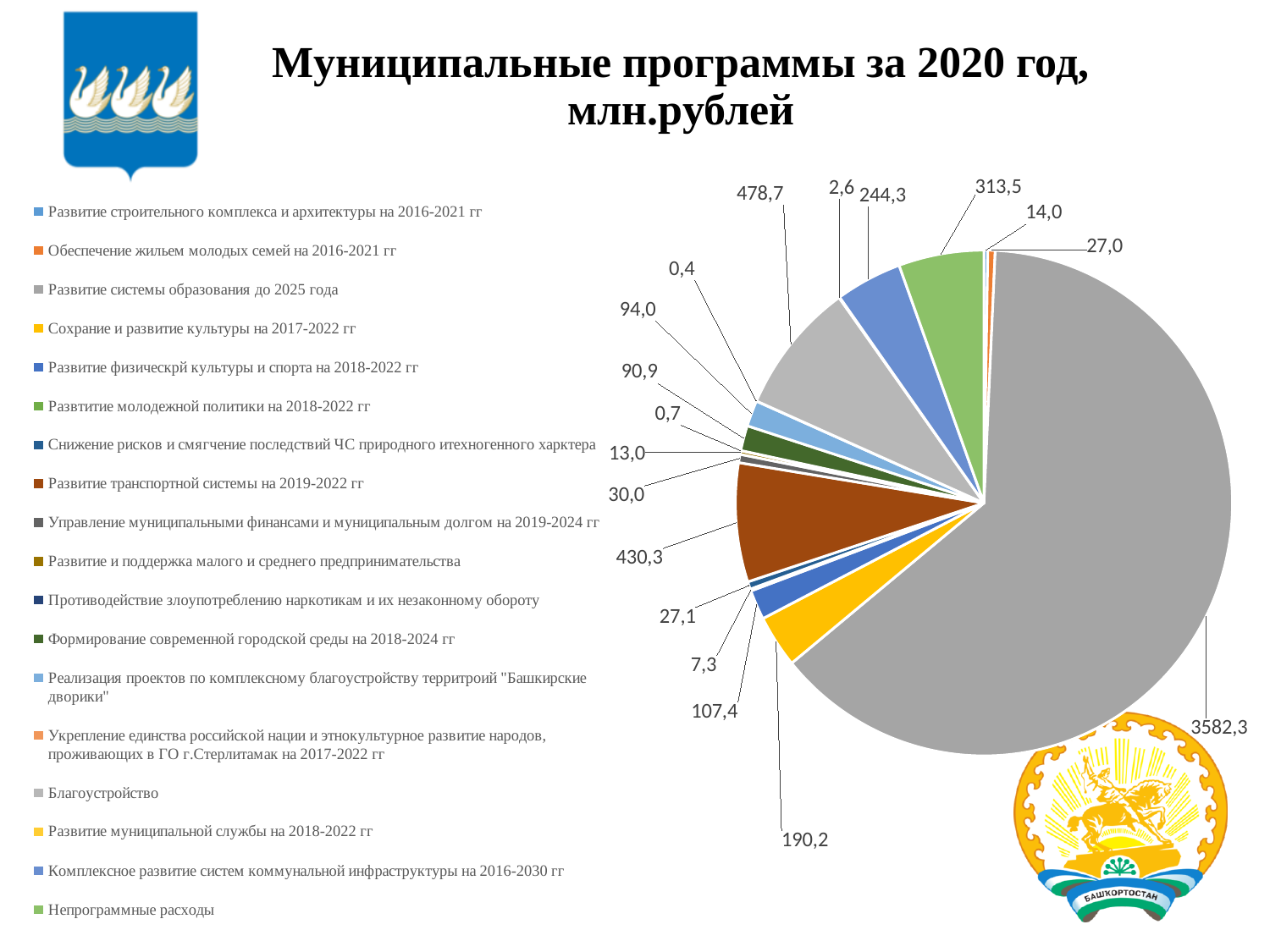
Which program has the largest slice of the pie? Развитие системы образования до 2025 года What is the value for Комплексное развитие систем коммунальной инфраструктуры на 2016-2030 гг? 244,3 What kind of chart is shown on the slide? pie chart What is the difference between the values for Непрограммные расходы and Комплексное развитие систем коммунальной инфраструктуры на 2016-2030 гг? 69,2 What is the smallest value labelled on the pie chart? 0,4 What is the value for Непрограммные расходы? 313,5 Which is larger: the slice for Благоустройство or the slice for Развитие транспортной системы на 2019-2022 гг? Благоустройство What is the title of the chart? Муниципальные программы за 2020 год, млн.рублей What is the value of the largest slice of the pie? 3582,3 How many categories does the legend of the pie chart list? 18 What is the value for Благоустройство? 478,7 What is the value for Развитие транспортной системы на 2019-2022 гг? 430,3